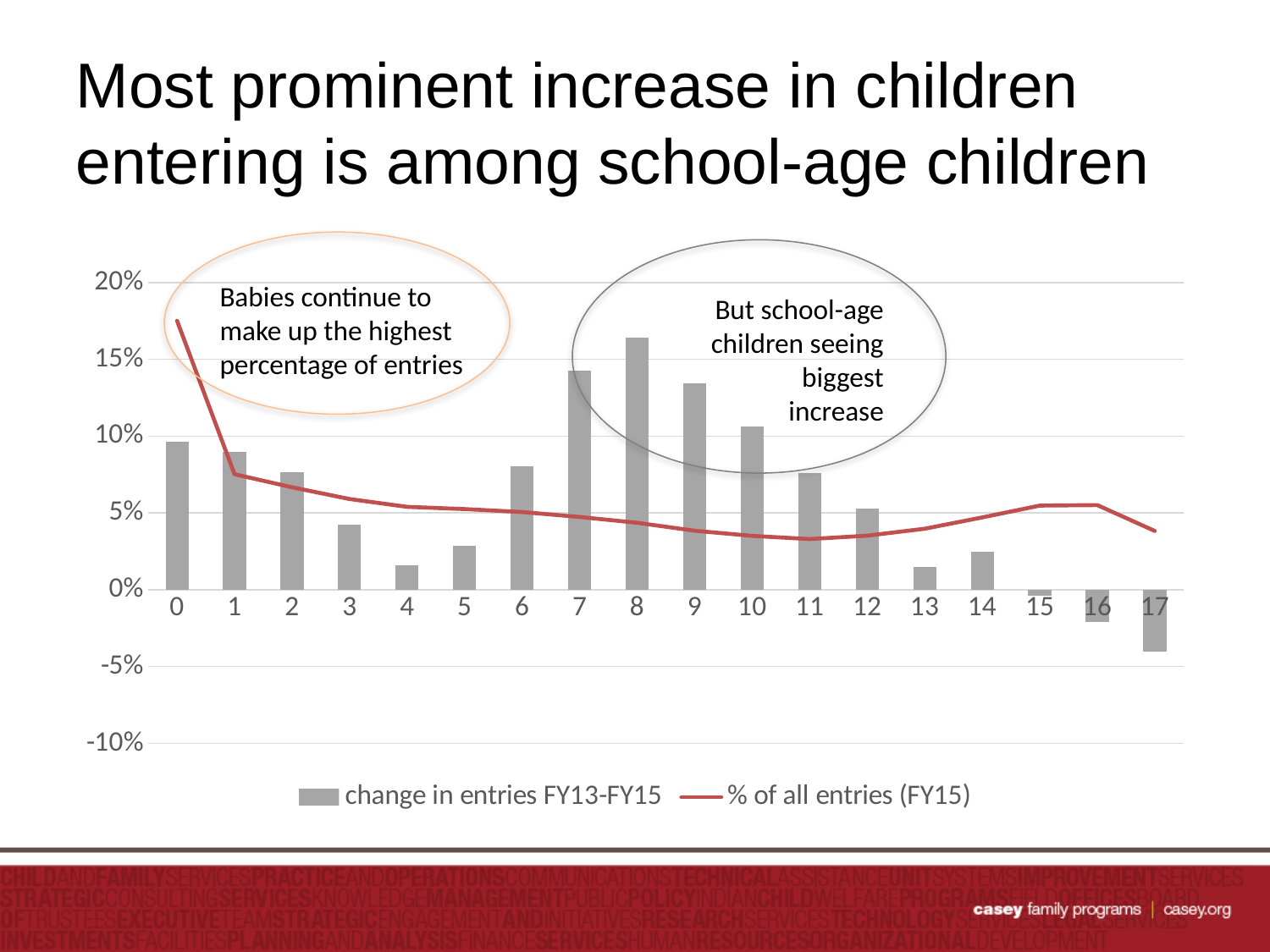
How many age categories are shown on the x axis? 18 Does the % of all entries (FY15) line rise or fall from age 0 to age 11? Fall Which age has the lowest bar for change in entries FY13-FY15? 17 What colour is the % of all entries (FY15) line? Red Is the % of all entries (FY15) value for age 0 greater or less than 15%? greater Which has the larger change in entries FY13-FY15 bar, age 8 or age 10? Age 8 How many series does the legend list? 2 What kind of chart is shown on the slide? A combined bar and line chart Is the change in entries FY13-FY15 bar for age 8 greater or less than 15%? greater Is the change in entries FY13-FY15 bar for age 4 greater or less than 5%? less Which age has the highest bar for change in entries FY13-FY15? 8 Which age has the highest value on the % of all entries (FY15) line? 0